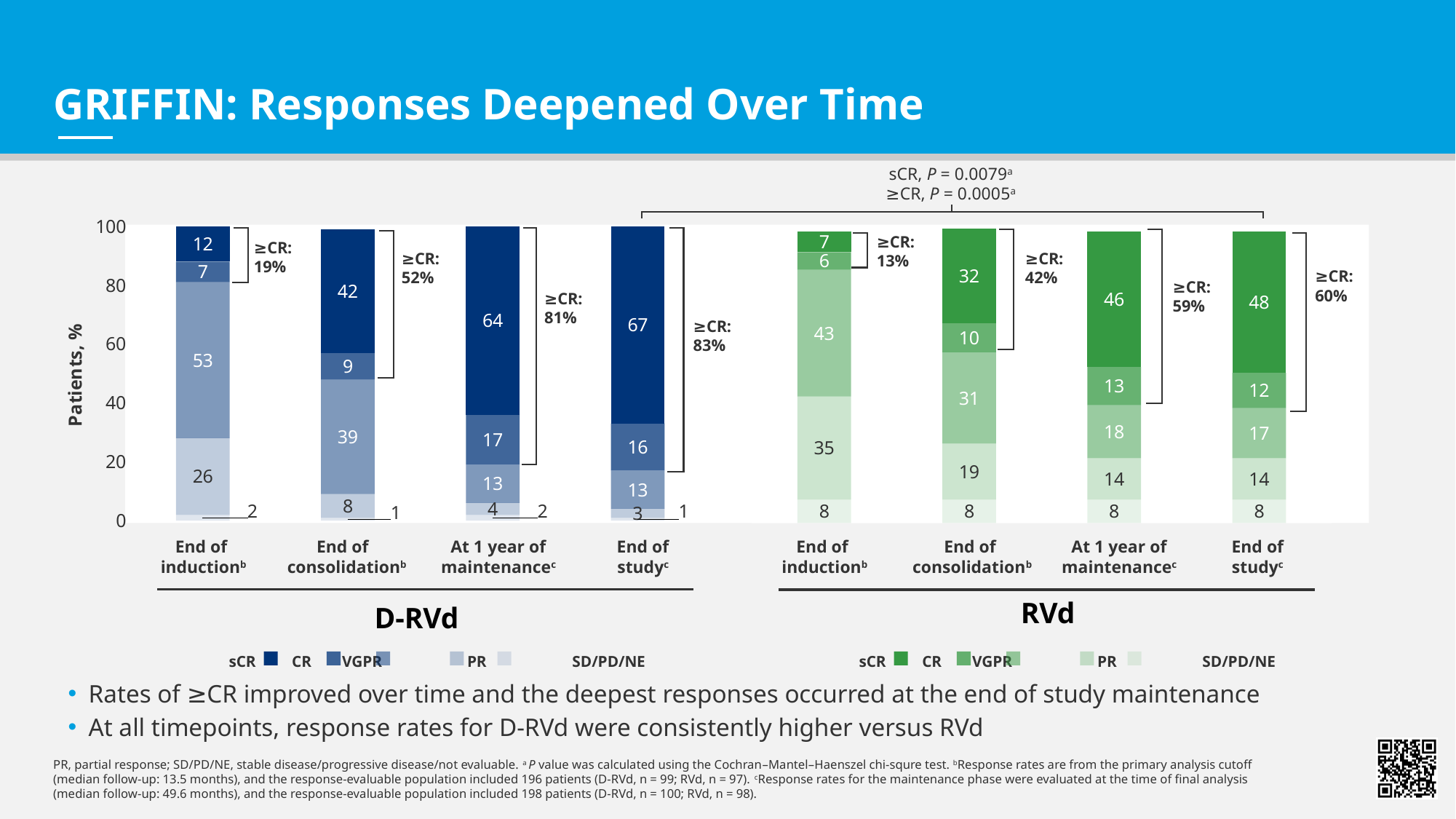
In the RVd chart, what is the VGPR value at end of induction? 43 In the D-RVd chart, what ≥CR rate is shown for end of consolidation? 52% How many response categories does the legend of the D-RVd chart list? 5 In the D-RVd chart, what is the sCR value at end of study? 67 In the D-RVd chart, at which timepoint is the sCR value highest? End of study What is the difference between the sCR value at end of study in the D-RVd chart and the sCR value at end of study in the RVd chart? 19 How many timepoints (bars) are shown in the RVd chart? 4 In the D-RVd chart, does the sCR value rise or fall from end of induction to end of study? Rise In the RVd chart, at which timepoint is the PR value lowest? At 1 year of maintenance and end of study (both 14) What kind of chart is used to show the D-RVd responses? Stacked bar chart Which is larger: the CR value at end of consolidation in the D-RVd chart or the CR value at end of consolidation in the RVd chart? RVd (10 vs 9) In the RVd chart, what ≥CR rate is shown at 1 year of maintenance? 59%